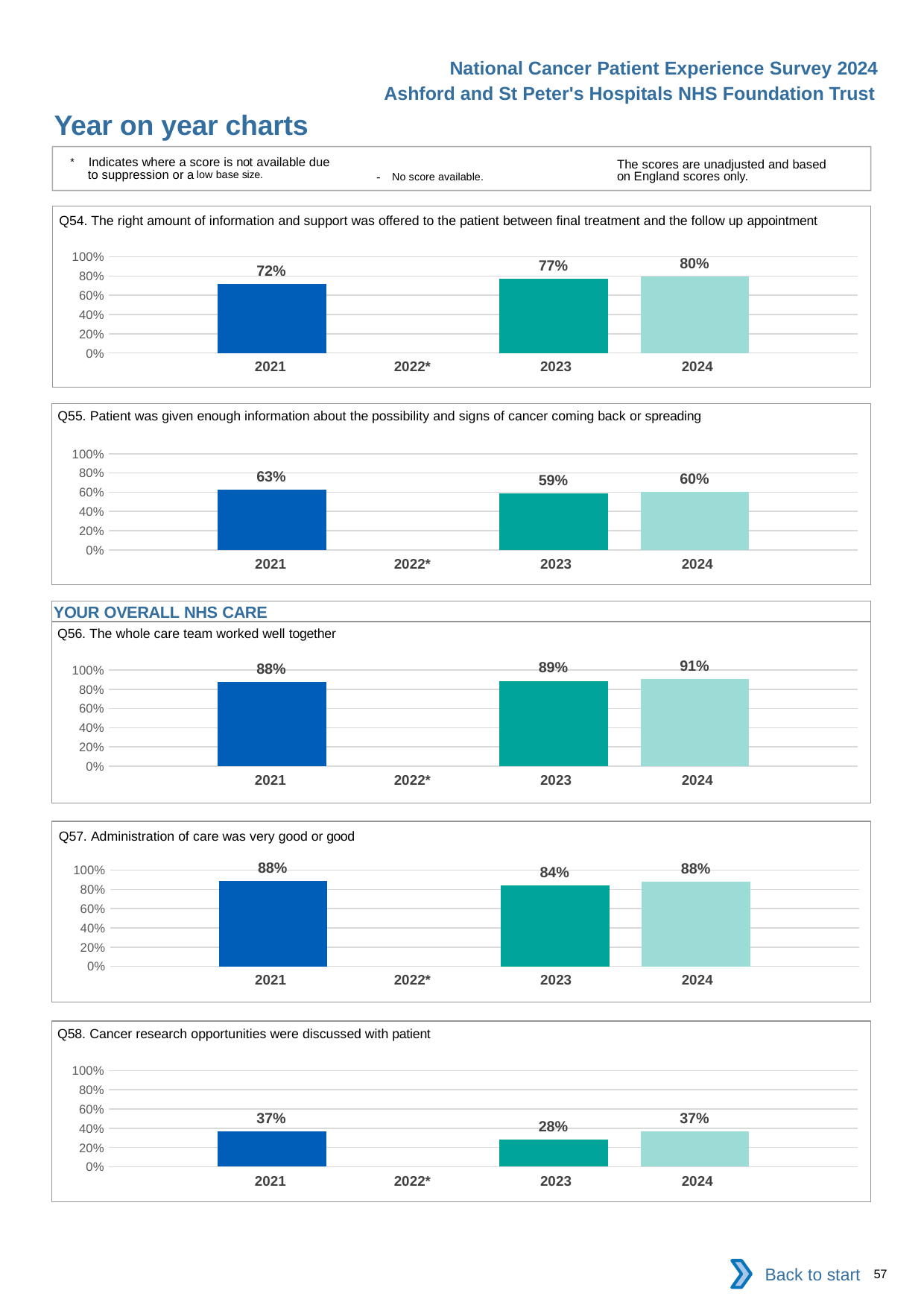
In the Q55 chart, what is the difference between the 2021 and 2023 values? 4% In the Q54 chart, what is the value for 2024? 80% In the Q56 chart, what is the value for 2023? 89% In the Q54 chart, do the plotted values rise or fall from 2021 to 2024? rise What kind of chart is the Q57 chart? bar chart In the Q58 chart, what is the value for 2023? 28% How many year categories are shown on the x axis of the Q56 chart? 4 Which year on the x axis of the Q58 chart is marked with an asterisk? 2022* In the Q55 chart, which year has the highest value? 2021 In the Q58 chart, is the value for 2021 larger or smaller than the value for 2023? larger In the Q54 chart, what is the difference between the 2024 and 2021 values? 8% In the Q57 chart, which year has the lowest value? 2023